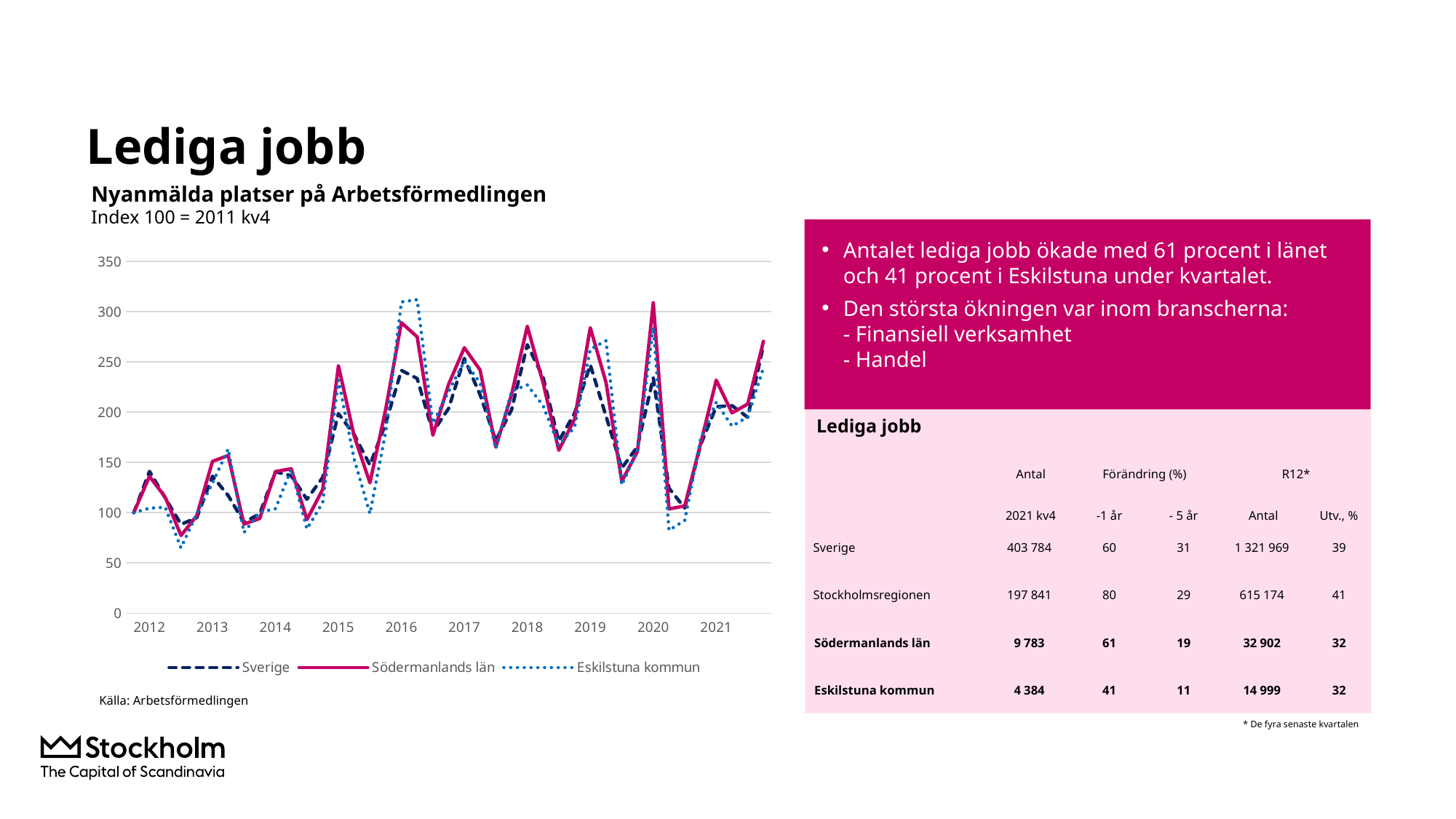
Is the highest value reached by Eskilstuna kommun in 2016 greater or less than 300? greater How many years are labelled on the x axis of the chart? 10 What is the title of the chart? Nyanmälda platser på Arbetsförmedlingen Is the value for Sverige at the end of 2021 greater or less than 200? greater Is the peak value for Södermanlands län in 2018 greater or less than 250? greater Which series are listed in the chart legend? Sverige, Södermanlands län, Eskilstuna kommun How many series does the chart legend list? 3 What kind of chart is shown on the slide? line chart